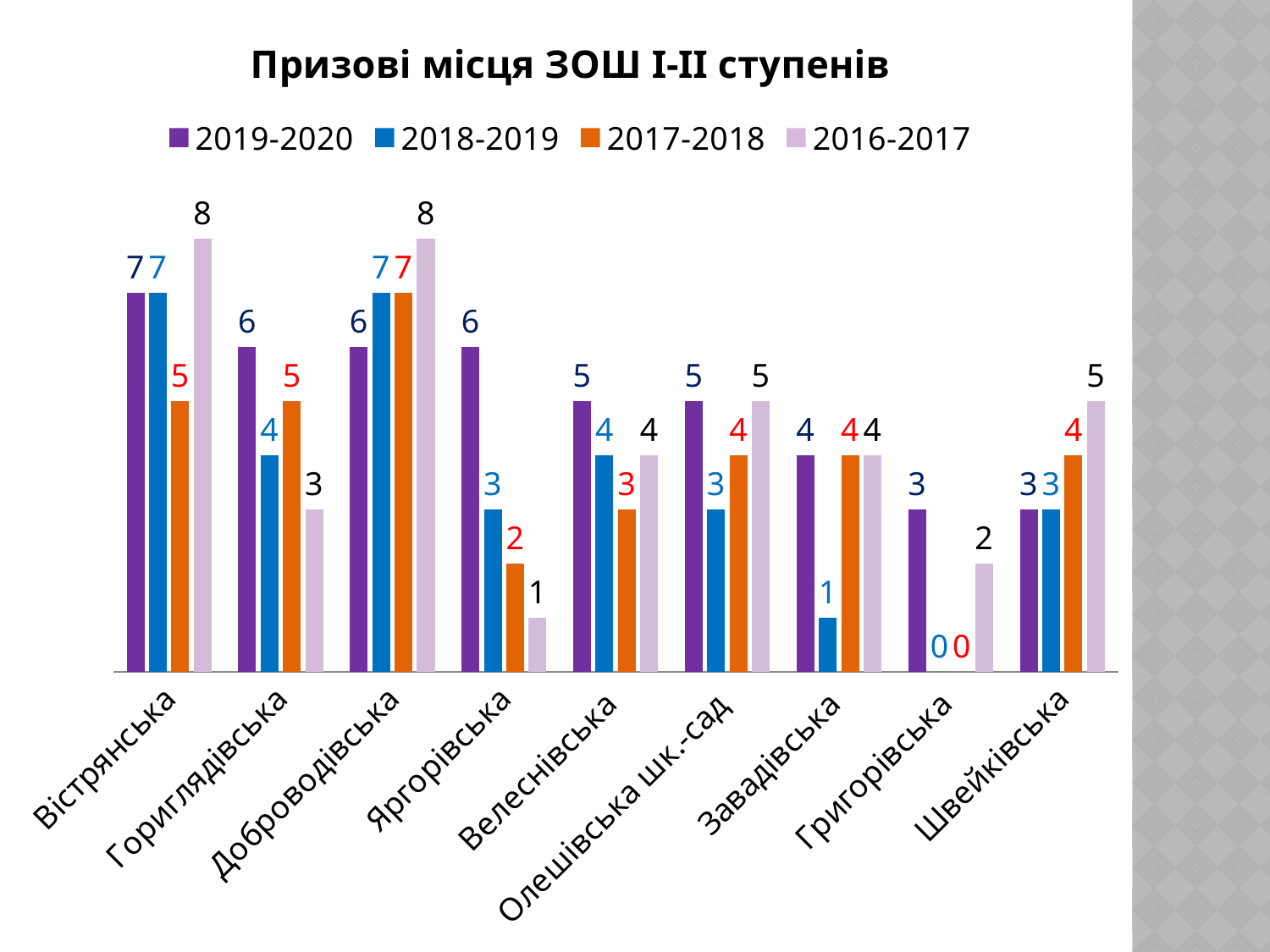
What is the title of the chart? Призові місця ЗОШ І-ІІ ступенів What is the value for Вістрянська in the 2016-2017 series? 8 What is the difference between the 2019-2020 and 2016-2017 values for Яргорівська? 5 How many series does the legend list? 4 Which category has the lowest value in the 2016-2017 series? Яргорівська What is the value for Яргорівська in the 2019-2020 series? 6 How many schools (categories) are shown on the x axis? 9 Which is larger for Гориглядівська: the 2018-2019 value or the 2017-2018 value? 2017-2018 Which category has the highest value in the 2019-2020 series? Вістрянська What kind of chart is shown on the slide? Bar chart What is the value for Григорівська in the 2018-2019 series? 0 What is the value for Завадівська in the 2017-2018 series? 4